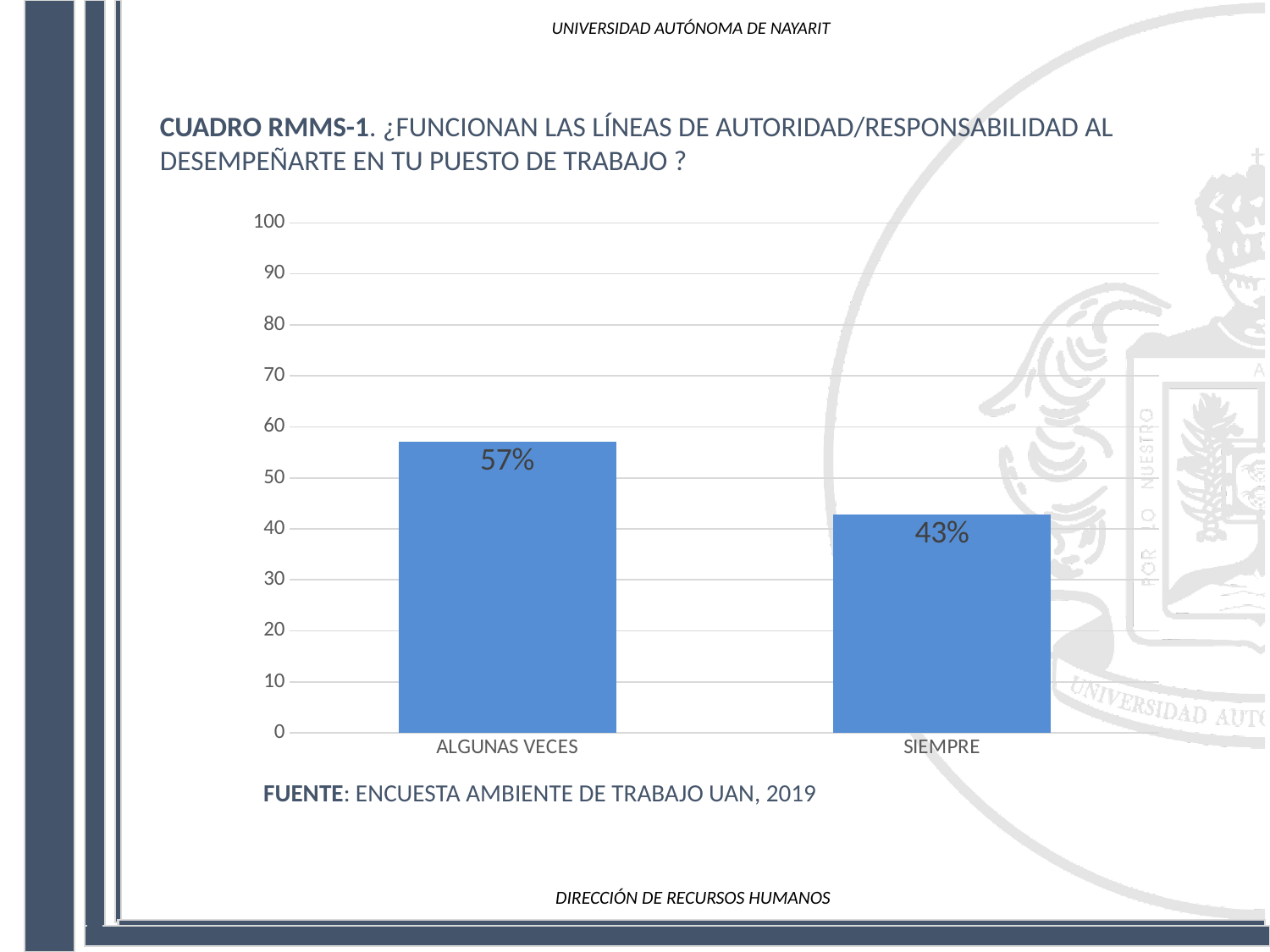
What source is cited below the chart? ENCUESTA AMBIENTE DE TRABAJO UAN, 2019 Is the value for SIEMPRE greater or less than 50? less Which category has the lowest value? SIEMPRE What is the difference between the values for ALGUNAS VECES and SIEMPRE? 14% Which is larger, the value for ALGUNAS VECES or the value for SIEMPRE? ALGUNAS VECES Is the value for ALGUNAS VECES greater or less than 50? greater What is the value for ALGUNAS VECES? 57% What is the total of the two values shown? 100% How many categories are shown on the x axis? 2 What is the value for SIEMPRE? 43% Which category has the highest value? ALGUNAS VECES What kind of chart is shown on the slide? bar chart